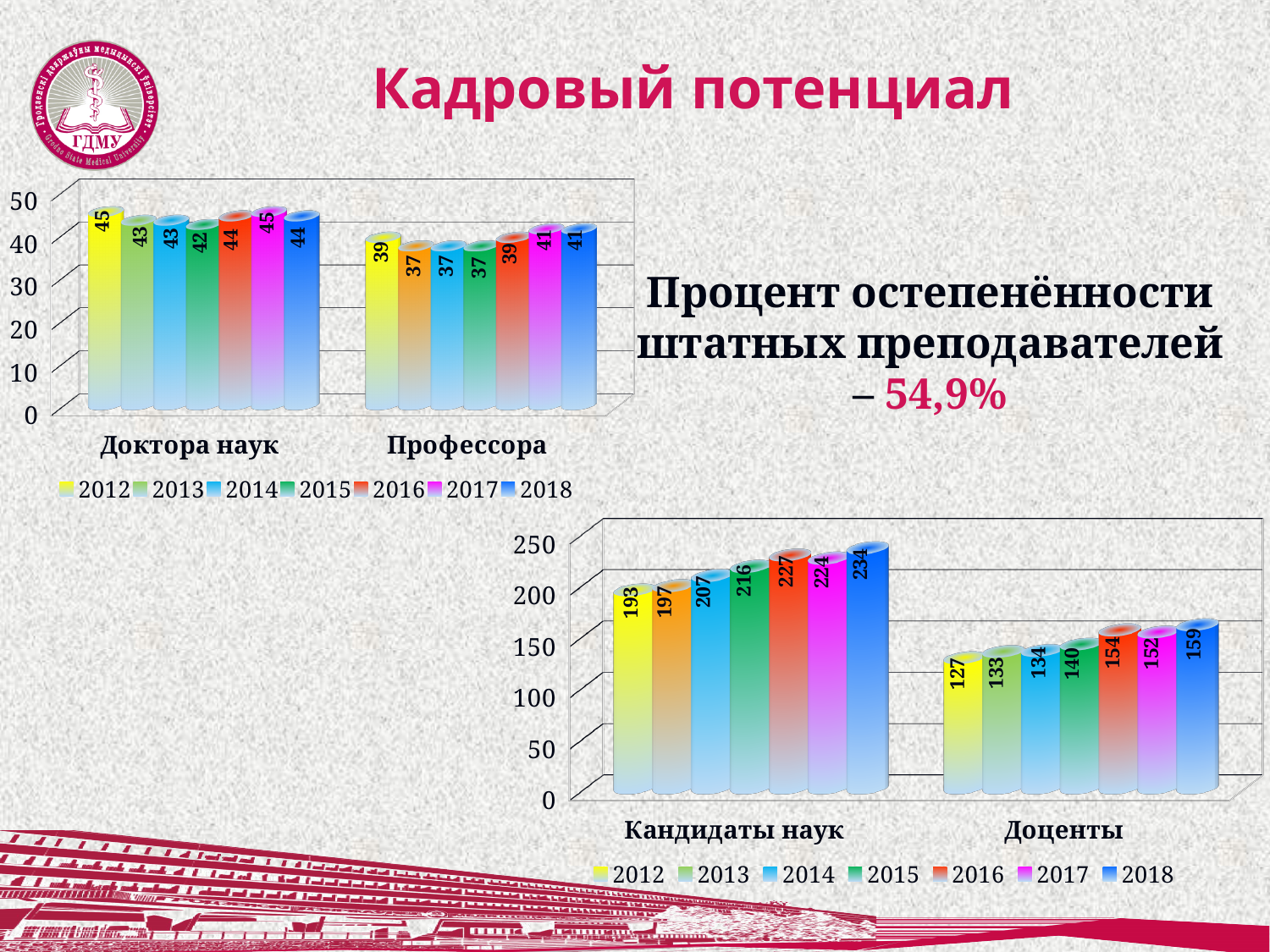
In the top-left chart, what is the value for Доктора наук in 2012? 45 In the bottom-right chart, which year has the highest value for Кандидаты наук? 2018 In the bottom-right chart, which year has the lowest value for Доценты? 2012 What kind of chart is the bottom-right chart? Bar chart In the top-left chart, what is the value for Профессора in 2017? 41 In the bottom-right chart, how many categories are shown on the x axis? 2 In the top-left chart, what is the difference between Доктора наук and Профессора in 2015? 5 In the bottom-right chart, is the value for Доценты in 2018 greater or less than 150? greater In the bottom-right chart, what is the value for Кандидаты наук in 2018? 234 In the top-left chart, how many series does the legend list? 7 In the bottom-right chart, what is the value for Доценты in 2016? 154 In the bottom-right chart, what is the difference between Кандидаты наук and Доценты in 2012? 66